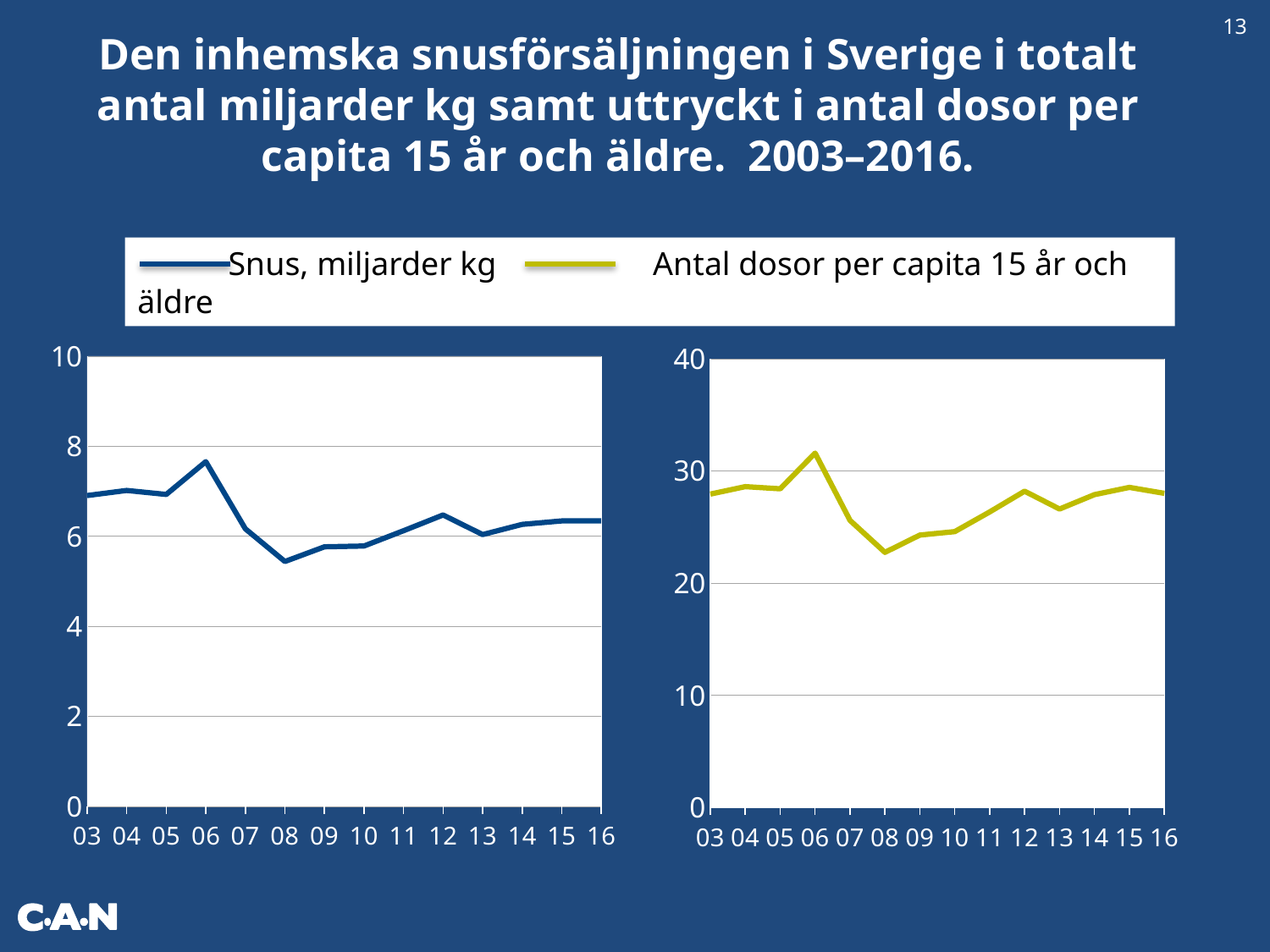
How many years are plotted on the x axis of the left chart (Snus, miljarder kg)? 14 In the right chart (Antal dosor per capita 15 år och äldre), is the value for 06 greater or less than 30? greater In the right chart (Antal dosor per capita 15 år och äldre), is the value for 08 greater or less than 30? less In the right chart (Antal dosor per capita 15 år och äldre), which is larger, the value for 03 or the value for 08? 03 In the left chart (Snus, miljarder kg), which year has the lowest value? 08 In the left chart (Snus, miljarder kg), which year has the highest value? 06 In the right chart (Antal dosor per capita 15 år och äldre), which year has the lowest value? 08 In the left chart (Snus, miljarder kg), do the values rise or fall from 06 to 08? fall In the right chart (Antal dosor per capita 15 år och äldre), which year has the highest value? 06 In the left chart (Snus, miljarder kg), is the value for 08 greater or less than 6? less How many series does the legend list? 2 What kind of chart is the left chart (Snus, miljarder kg)? line chart